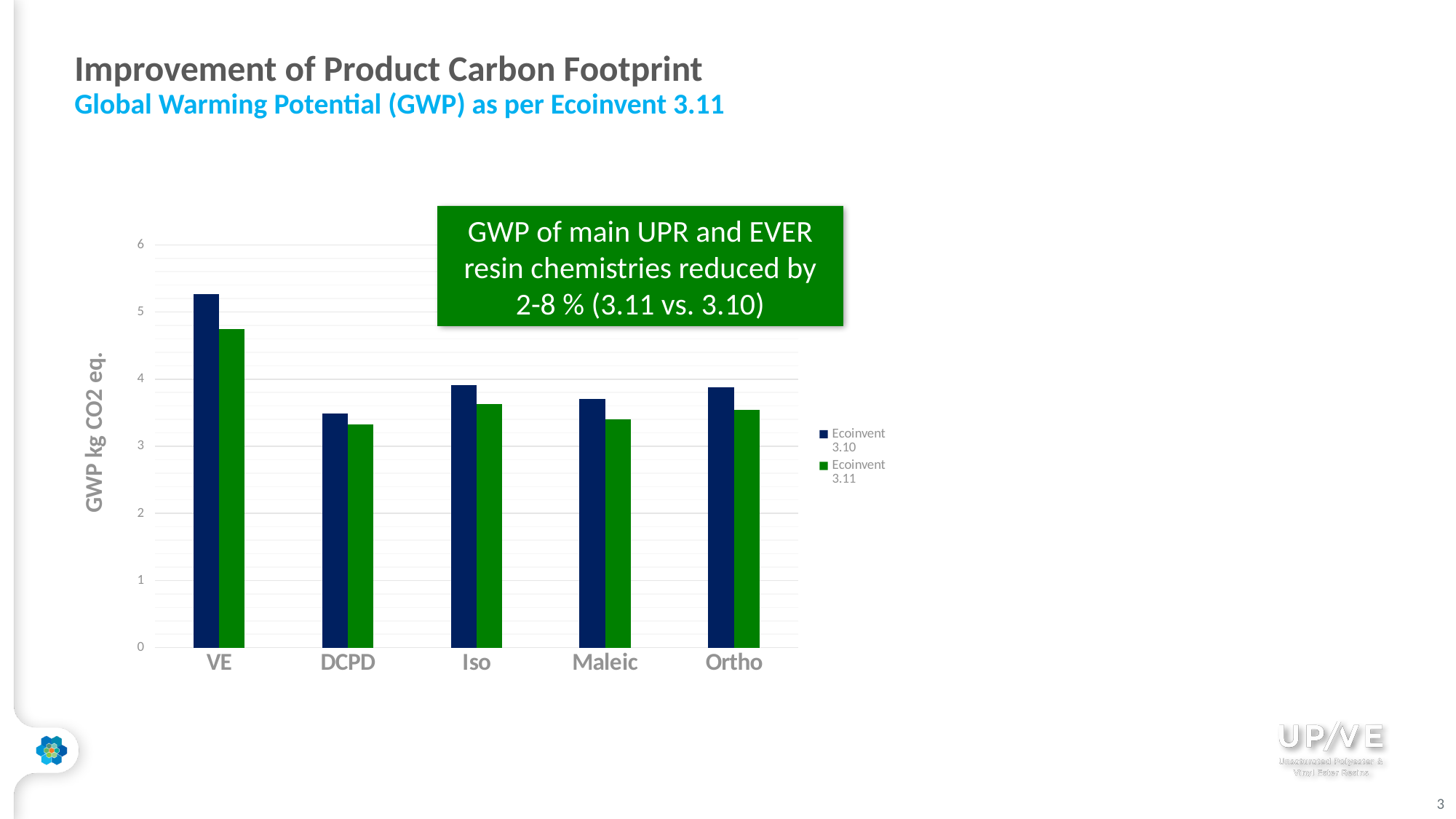
Which category has the lowest GWP value for Ecoinvent 3.11? DCPD Which category has the lowest GWP value for Ecoinvent 3.10? DCPD What is the label of the y axis? GWP kg CO2 eq. Which is larger, the Ecoinvent 3.10 value for VE or the Ecoinvent 3.10 value for DCPD? VE How many series does the legend list? 2 Is the Ecoinvent 3.10 value for Iso greater or less than 3? greater For VE, which is larger, the Ecoinvent 3.10 value or the Ecoinvent 3.11 value? Ecoinvent 3.10 Is the Ecoinvent 3.11 value for DCPD greater or less than 4? less Is the Ecoinvent 3.10 value for VE greater or less than 5? greater What kind of chart is shown on the slide? bar chart How many resin categories are shown on the x axis? 5 Which category has the highest GWP value for Ecoinvent 3.10? VE